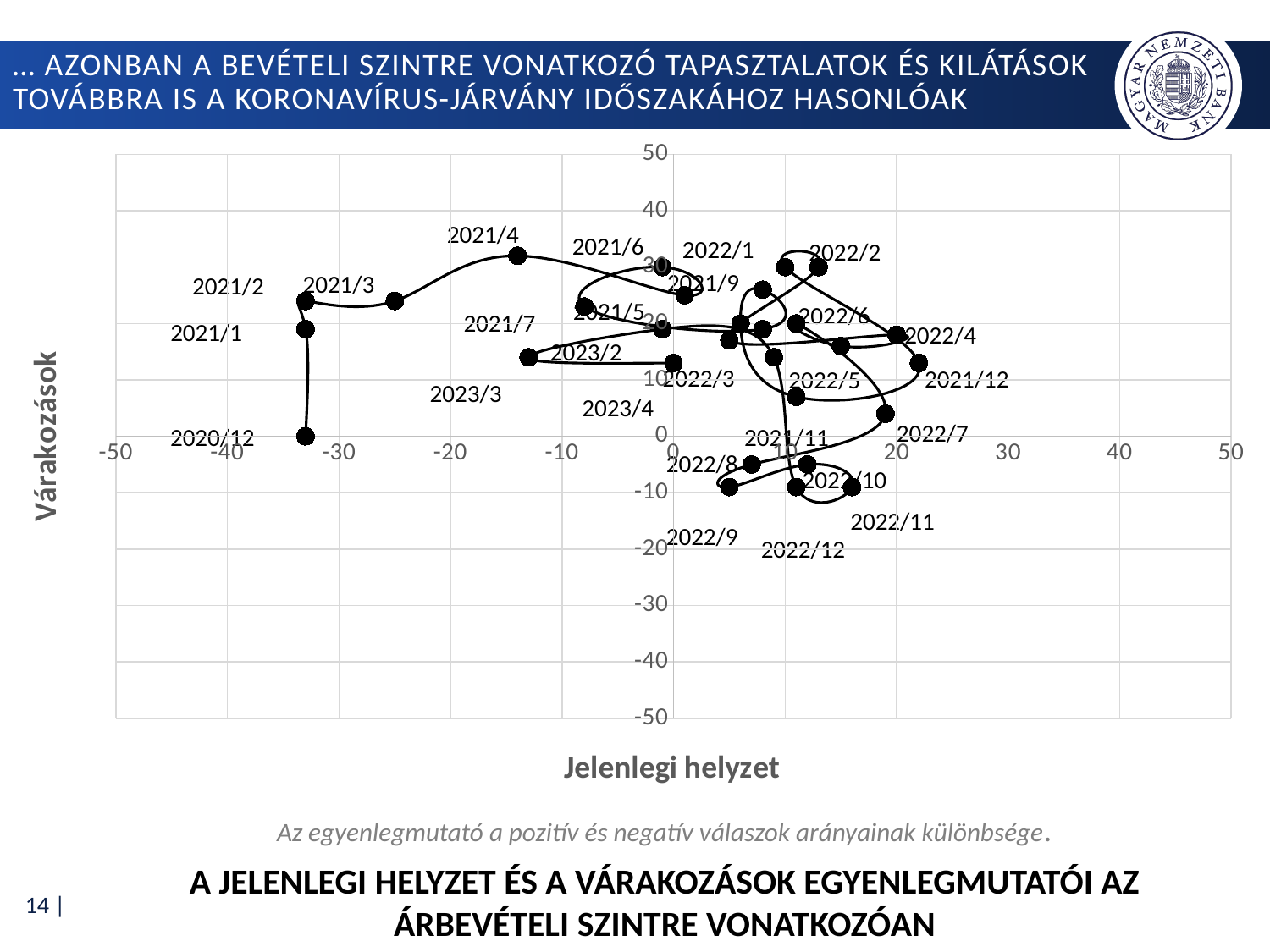
What is the title of the vertical axis of the chart? Várakozások Is the vertical-axis value (Várakozások) for 2021/4 greater or less than 30? greater What is the title of the horizontal axis of the chart? Jelenlegi helyzet Is the horizontal-axis value (Jelenlegi helyzet) for 2021/12 greater or less than 10? greater Is the horizontal-axis value (Jelenlegi helyzet) for 2022/4 greater or less than 10? greater Which point has the higher Várakozások (vertical-axis) value, 2021/3 or 2022/12? 2021/3 Which point has the higher Jelenlegi helyzet (horizontal-axis) value, 2021/2 or 2022/4? 2022/4 Which point has the higher Várakozások (vertical-axis) value, 2021/4 or 2020/12? 2021/4 What kind of chart is shown on the slide? scatter chart